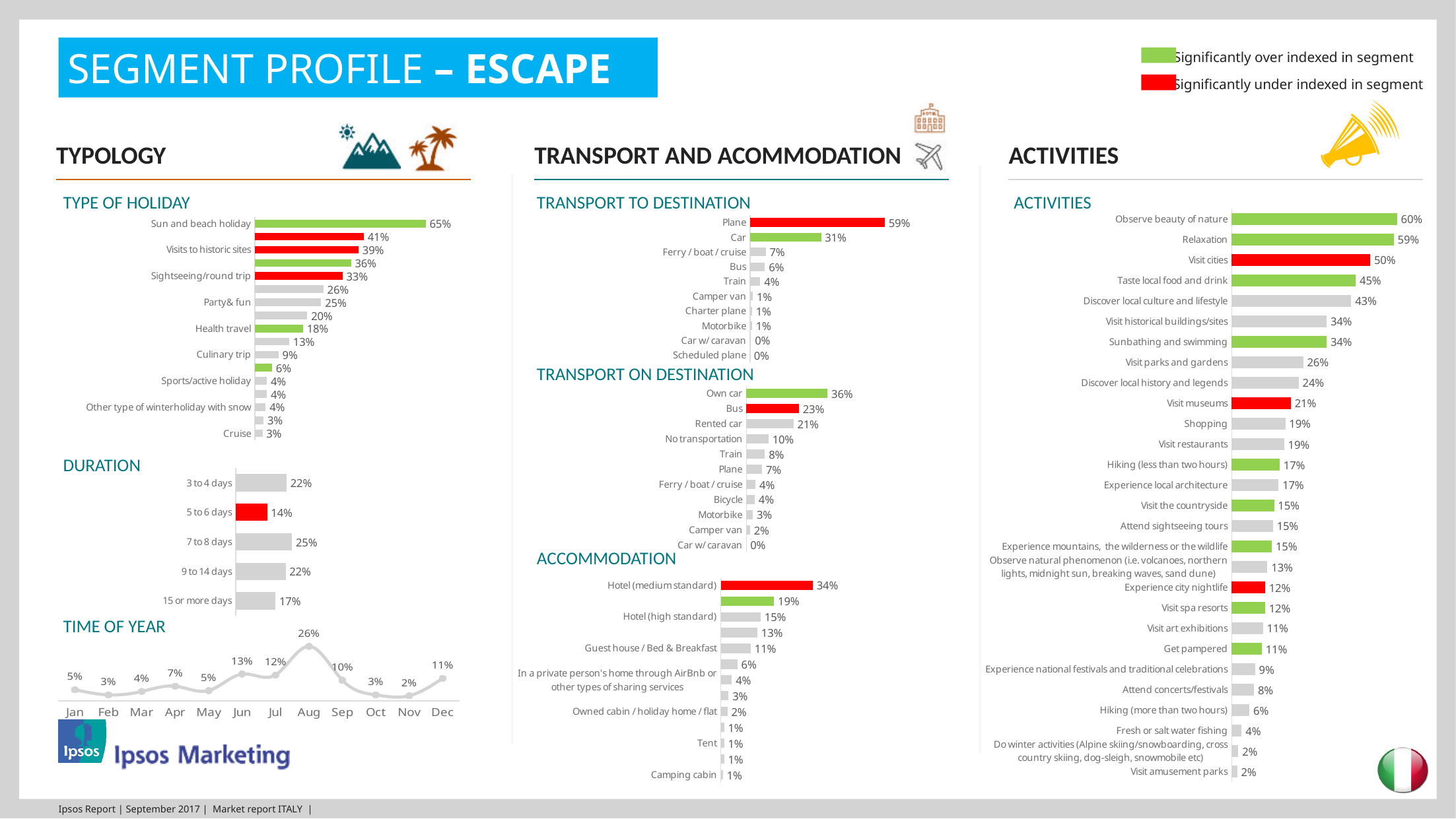
In the Accommodation chart, what is the value for Hotel (medium standard)? 34% What kind of chart is the Time of Year chart? Line chart How many categories are shown in the Duration chart? 5 According to the legend at the top right, what does a green bar indicate? Significantly over indexed in segment In the Time of Year chart, which month has the highest value? Aug In the Transport to Destination chart, what is the difference between the values for Plane and Car? 28 percentage points In the Duration chart, what is the value for 7 to 8 days? 25% In the Transport on Destination chart, which is larger, the value for Bus or for Rented car? Bus In the Activities chart, which activity has the highest value? Observe beauty of nature In the Activities chart, what is the value for Visit museums? 21% In the Duration chart, which category has the lowest value? 5 to 6 days In the Transport to Destination chart, what is the value for Plane? 59%